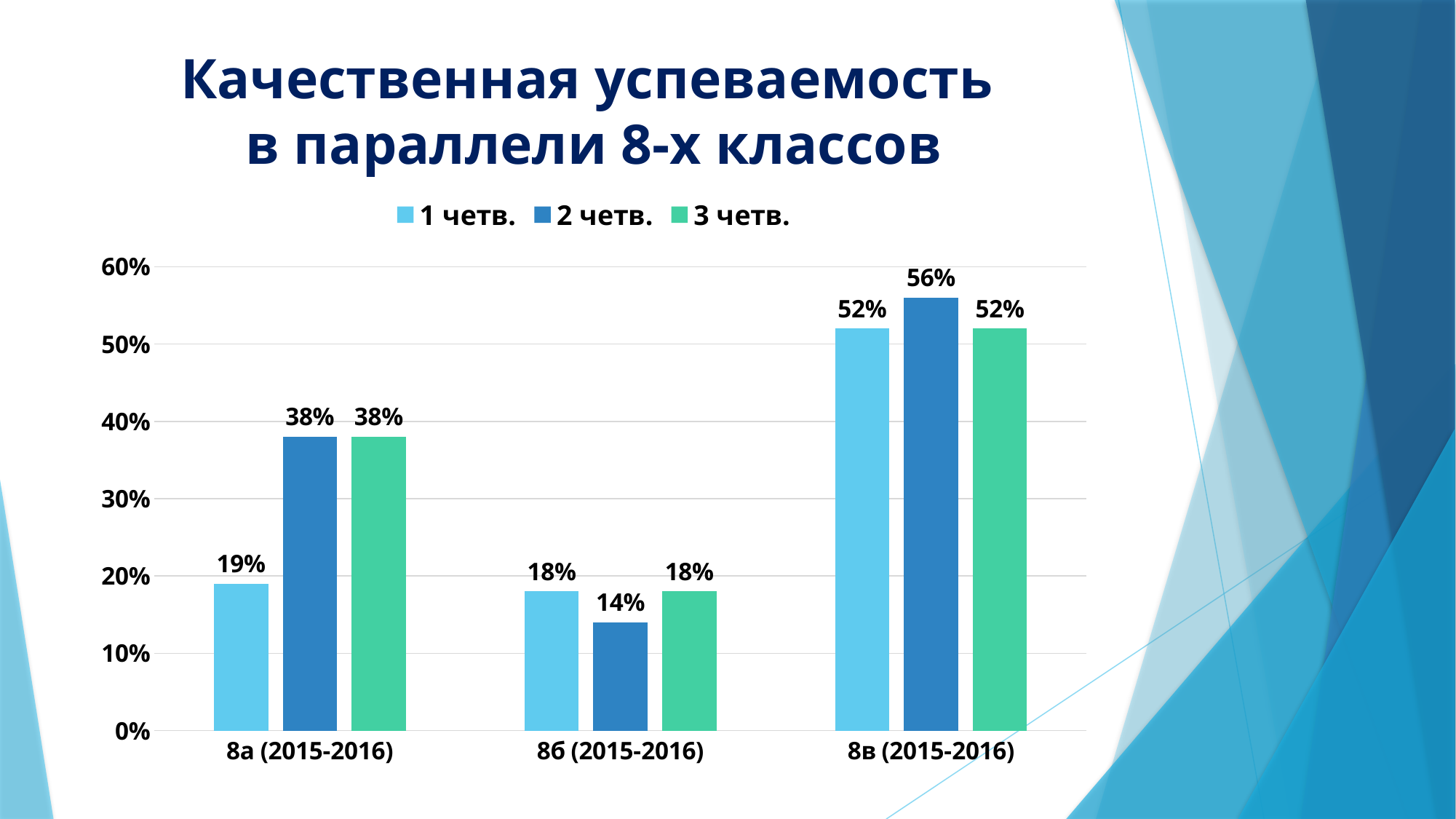
What is the value for 8в (2015-2016) in the 3 четв. series? 52% Which class has the lowest value in the 1 четв. series? 8б (2015-2016) What kind of chart is shown on the slide? bar chart How many series does the legend list? 3 Which class has the highest value in the 2 четв. series? 8в (2015-2016) Which is larger: the 1 четв. value for 8а (2015-2016) or the 1 четв. value for 8б (2015-2016)? 8а (2015-2016) Is the 2 четв. value for 8в (2015-2016) greater or less than 50%? greater How many classes (categories) are shown on the x axis? 3 What is the value for 8б (2015-2016) in the 2 четв. series? 14% What is the title of the chart on the slide? Качественная успеваемость в параллели 8-х классов What is the difference between the 2 четв. value for 8в (2015-2016) and the 2 четв. value for 8а (2015-2016)? 18% What is the value for 8а (2015-2016) in the 1 четв. series? 19%